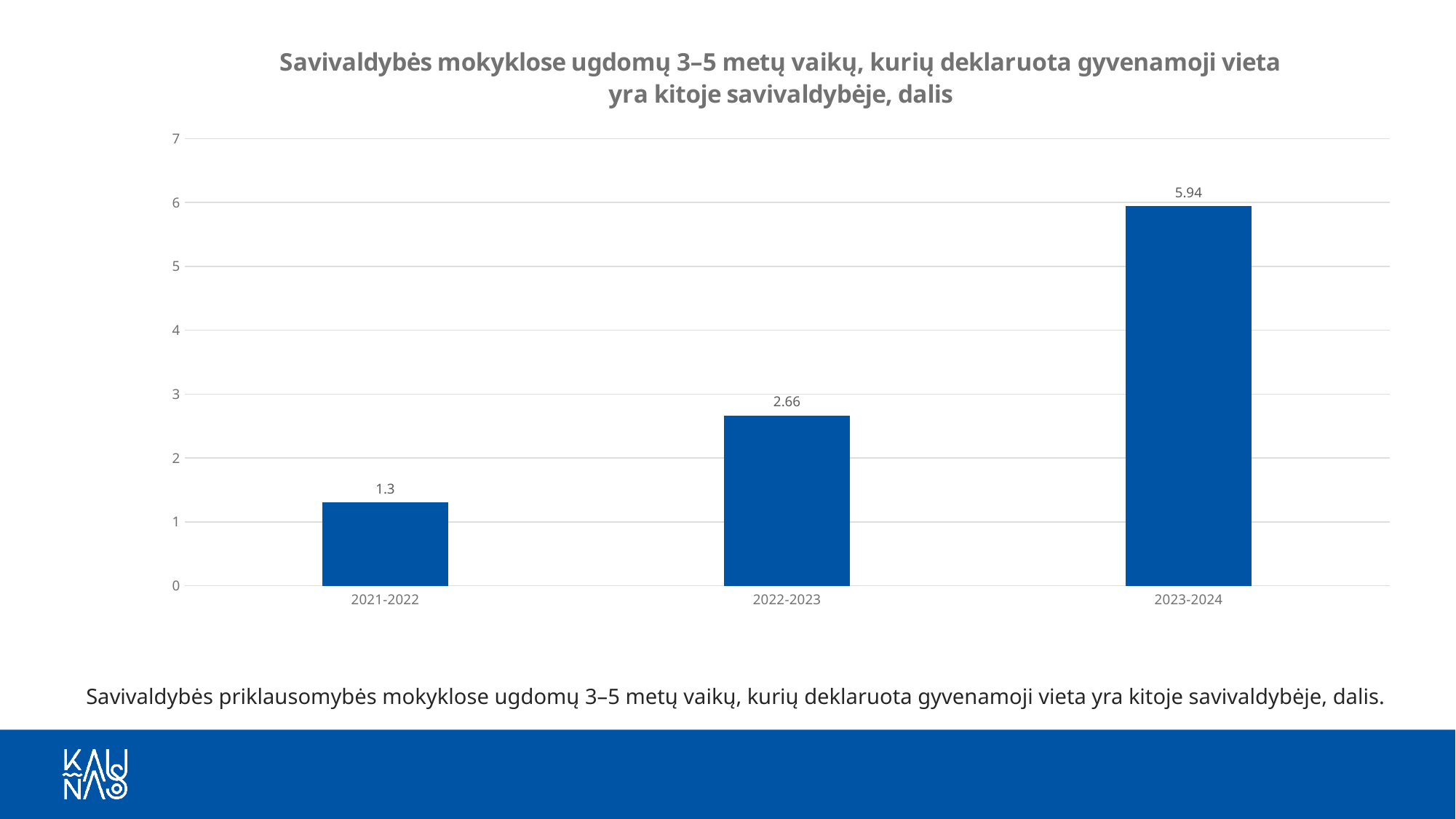
How many school years are shown on the chart? 3 What is the difference between the values for 2022-2023 and 2021-2022? 1.36 What is the difference between the values for 2023-2024 and 2022-2023? 3.28 Which is larger, the value for 2021-2022 or the value for 2022-2023? 2022-2023 Which school year has the highest value? 2023-2024 What is the value for 2023-2024? 5.94 What is the value for 2022-2023? 2.66 Which school year has the lowest value? 2021-2022 What is the value for 2021-2022? 1.3 Do the values rise or fall from 2021-2022 to 2023-2024? rise Is the value for 2023-2024 greater or less than 5? greater What kind of chart is shown on the slide? bar chart